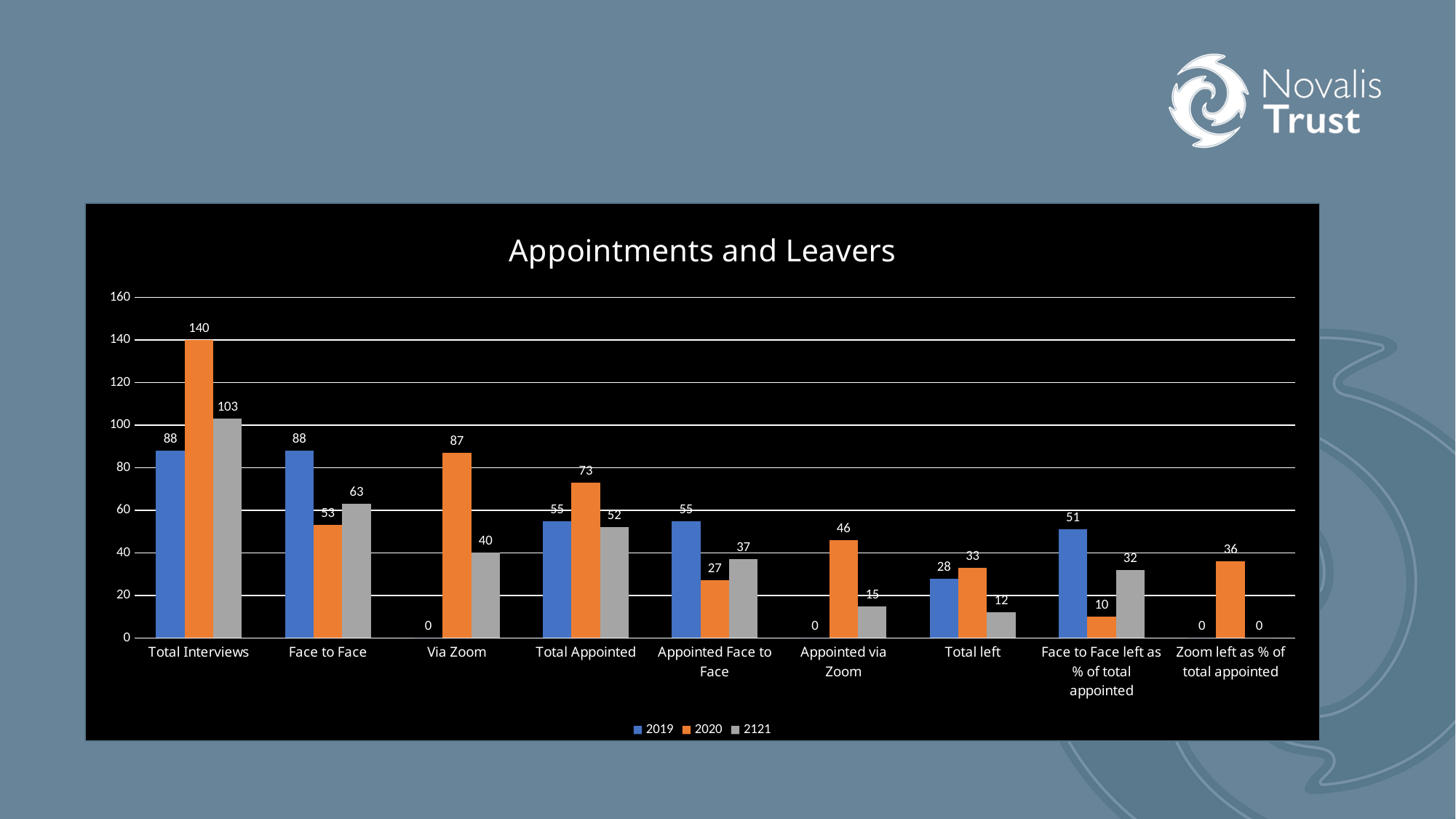
Which is larger for Face to Face: the 2019 value or the 2121 value? 2019 What is the difference between the 2020 and 2019 values for Total Interviews? 52 What kind of chart is shown? bar chart How many series does the legend list? 3 Which category has the highest 2020 value? Total Interviews What is the title of the chart? Appointments and Leavers What is the 2019 value for Total Appointed? 55 How many categories are shown on the x axis? 9 Is the 2121 value for Total Interviews greater or less than 100? greater What is the 2121 value for Appointed via Zoom? 15 Which category has the lowest 2121 value? Zoom left as % of total appointed What is the 2020 value for Total Interviews? 140